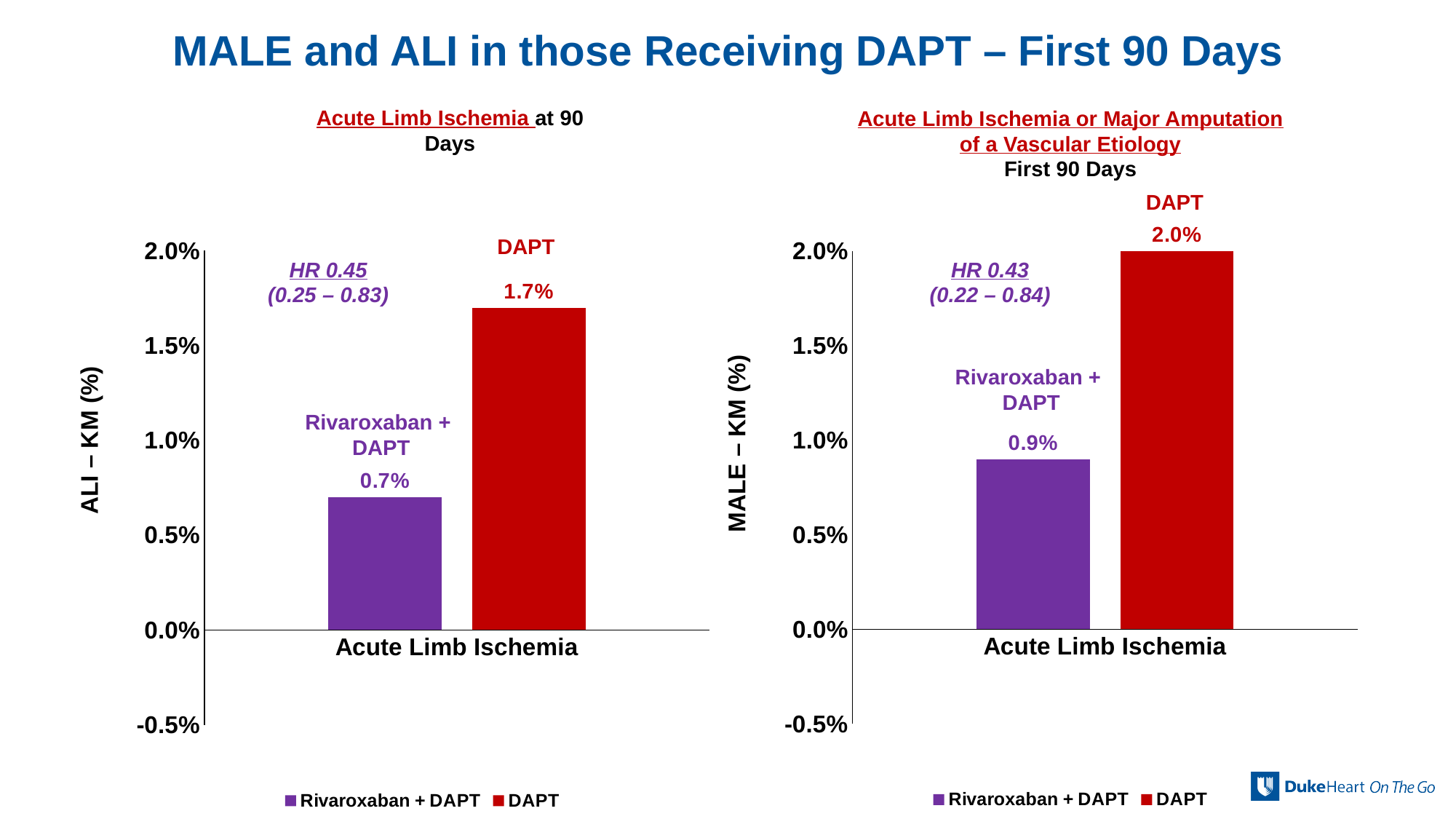
In the right chart (Acute Limb Ischemia or Major Amputation of a Vascular Etiology), which series has the lower value? Rivaroxaban + DAPT How many series does the legend of the left chart (Acute Limb Ischemia at 90 Days) list? 2 What kind of chart is the right chart (Acute Limb Ischemia or Major Amputation of a Vascular Etiology)? Bar chart In the left chart (Acute Limb Ischemia at 90 Days), what is the difference between the DAPT value and the Rivaroxaban + DAPT value? 1.0% In the left chart (Acute Limb Ischemia at 90 Days), what is the value for Rivaroxaban + DAPT? 0.7% In the right chart (Acute Limb Ischemia or Major Amputation of a Vascular Etiology), is the value for Rivaroxaban + DAPT greater or less than 1.0%? less In the right chart (Acute Limb Ischemia or Major Amputation of a Vascular Etiology), what is the value for Rivaroxaban + DAPT? 0.9% In the right chart (Acute Limb Ischemia or Major Amputation of a Vascular Etiology), what is the value for DAPT? 2.0% In the left chart (Acute Limb Ischemia at 90 Days), what is the value for DAPT? 1.7% In the left chart (Acute Limb Ischemia at 90 Days), which series has the higher value? DAPT In the right chart (Acute Limb Ischemia or Major Amputation of a Vascular Etiology), what is the difference between the DAPT value and the Rivaroxaban + DAPT value? 1.1% What is the y-axis label of the left chart (Acute Limb Ischemia at 90 Days)? ALI – KM (%)